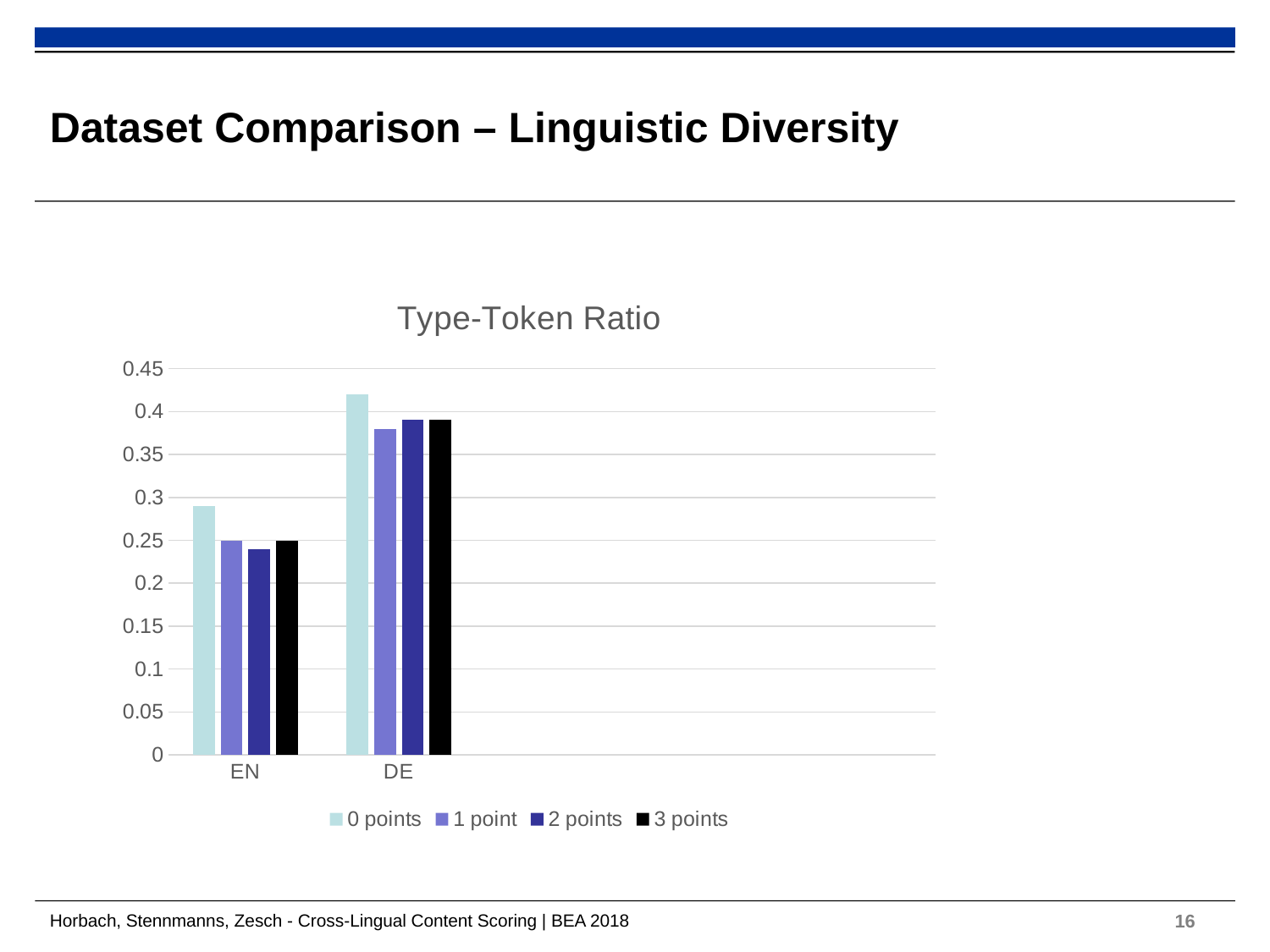
Which series has the highest value for EN? 0 points Which is larger, the 0 points value for EN or the 0 points value for DE? DE Is the 0 points value for DE greater or less than 0.4? greater Is the 0 points value for EN greater or less than 0.25? greater What kind of chart is shown on the slide? bar chart What is the title of the chart? Type-Token Ratio Which colour represents the 3 points series in the legend? black Which series has the highest value for DE? 0 points How many series does the legend list? 4 Is the 1 point value for DE greater or less than 0.4? less How many categories are shown on the x axis? 2